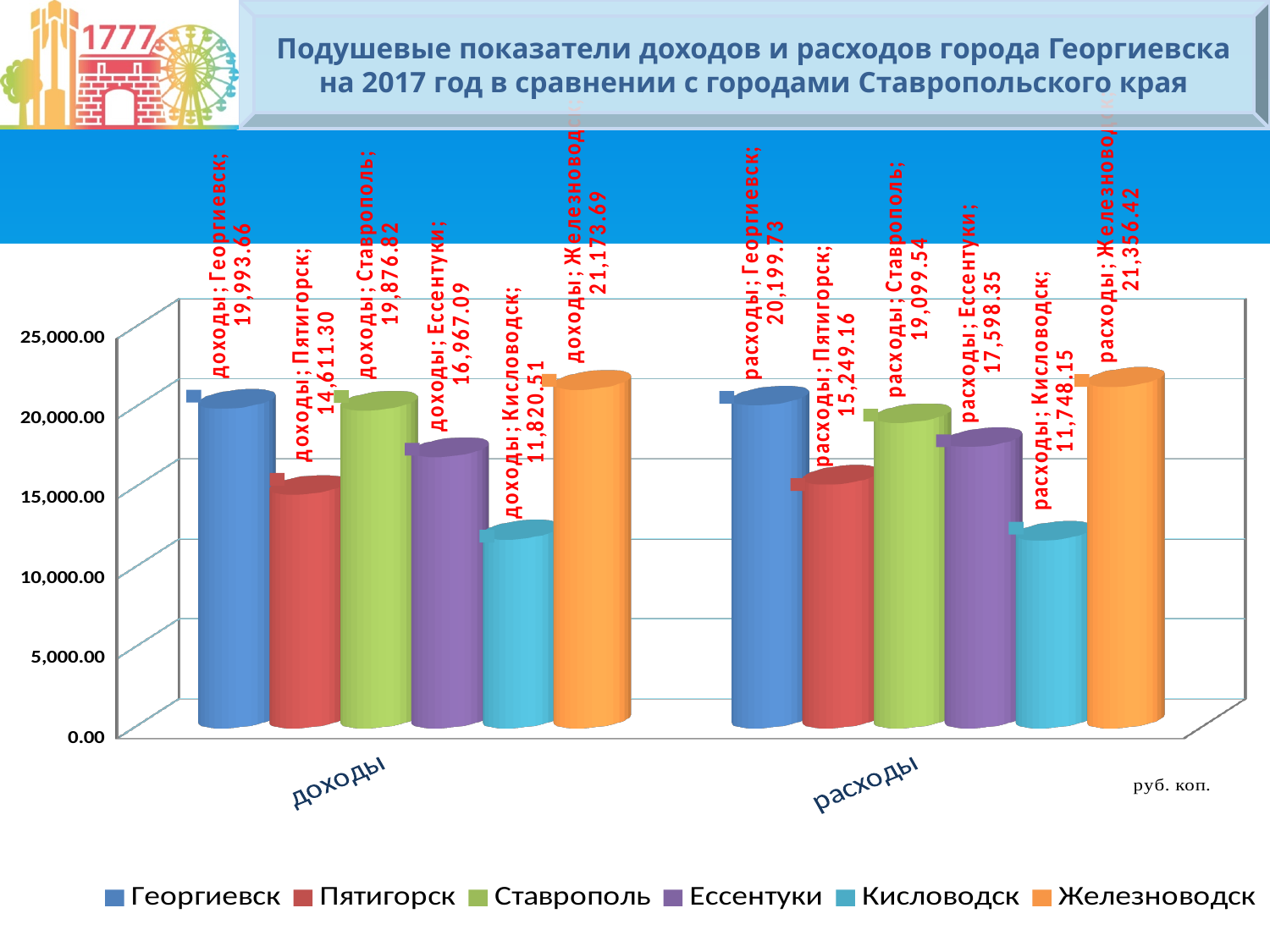
What colour represents Железноводск in the legend? orange What is the расходы value for Кисловодск? 11,748.15 Which city has the lowest расходы value? Кисловодск Which city has the highest доходы value? Железноводск Which is larger: the доходы value for Ставрополь or the доходы value for Ессентуки? Ставрополь How many categories are shown on the x axis? 2 What is the доходы value for Георгиевск? 19,993.66 What kind of chart is shown on the slide? bar chart How many series does the legend list? 6 What is the расходы value for Ессентуки? 17,598.35 Is the доходы value for Кисловодск greater or less than 15,000.00? less What is the difference between the расходы values for Железноводск and Пятигорск? 6,107.26